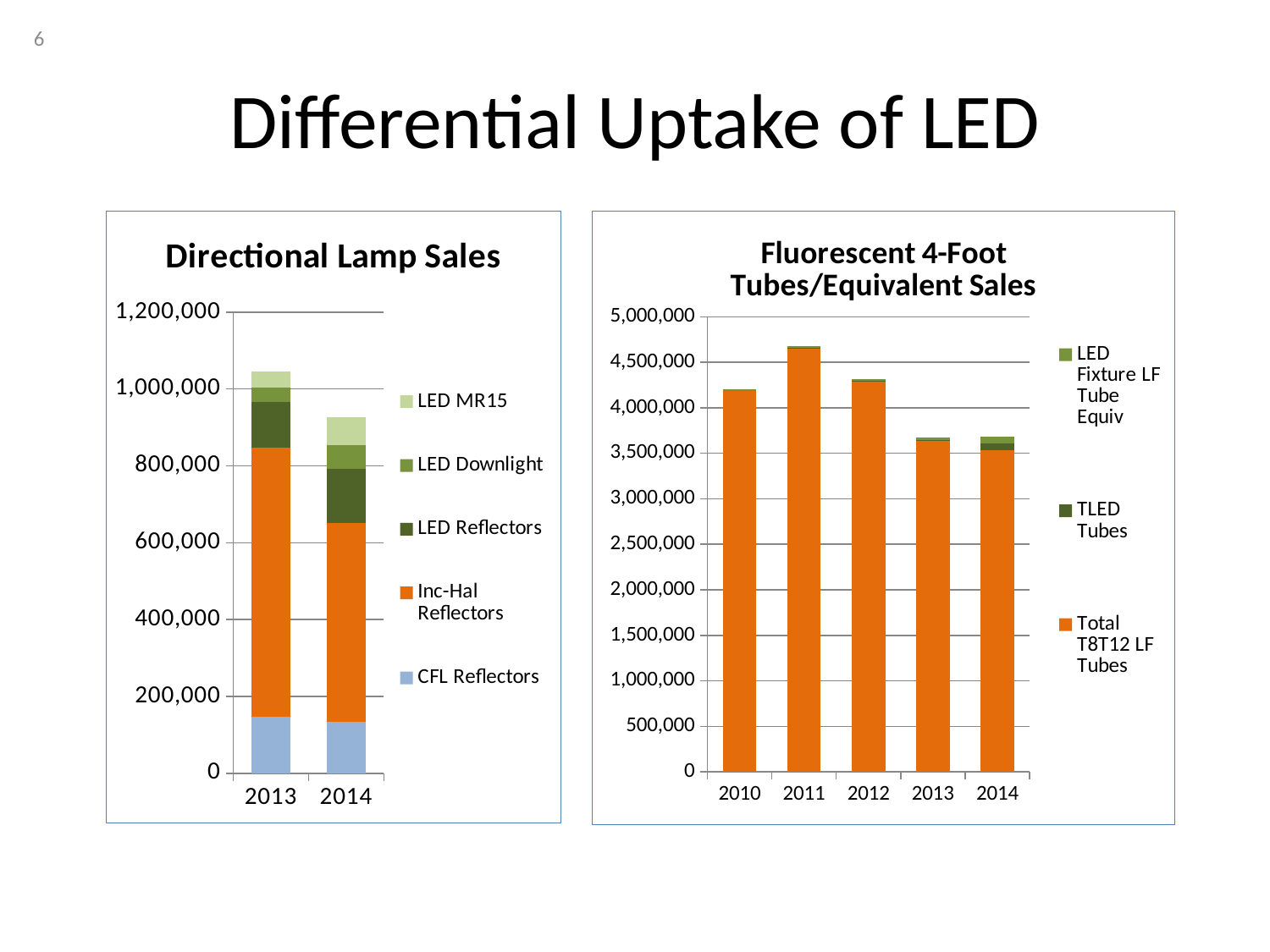
What type of chart is the Directional Lamp Sales chart? stacked bar chart How many series does the legend of the Fluorescent 4-Foot Tubes/Equivalent Sales chart list? 3 In the Directional Lamp Sales chart, is the total stacked value for 2013 greater or less than 1,000,000? greater How many years are shown on the x axis of the Fluorescent 4-Foot Tubes/Equivalent Sales chart? 5 How many years are shown on the x axis of the Directional Lamp Sales chart? 2 In the Fluorescent 4-Foot Tubes/Equivalent Sales chart, which year has the highest total bar? 2011 In the Directional Lamp Sales chart, which series is shown in the bottom (light blue) segment of each bar? CFL Reflectors In the Directional Lamp Sales chart, is the total stacked value for 2014 greater or less than 1,000,000? less How many series does the legend of the Directional Lamp Sales chart list? 5 In the Fluorescent 4-Foot Tubes/Equivalent Sales chart, is the total value for 2013 greater or less than 4,000,000? less In the Directional Lamp Sales chart, does the total bar height rise or fall from 2013 to 2014? fall